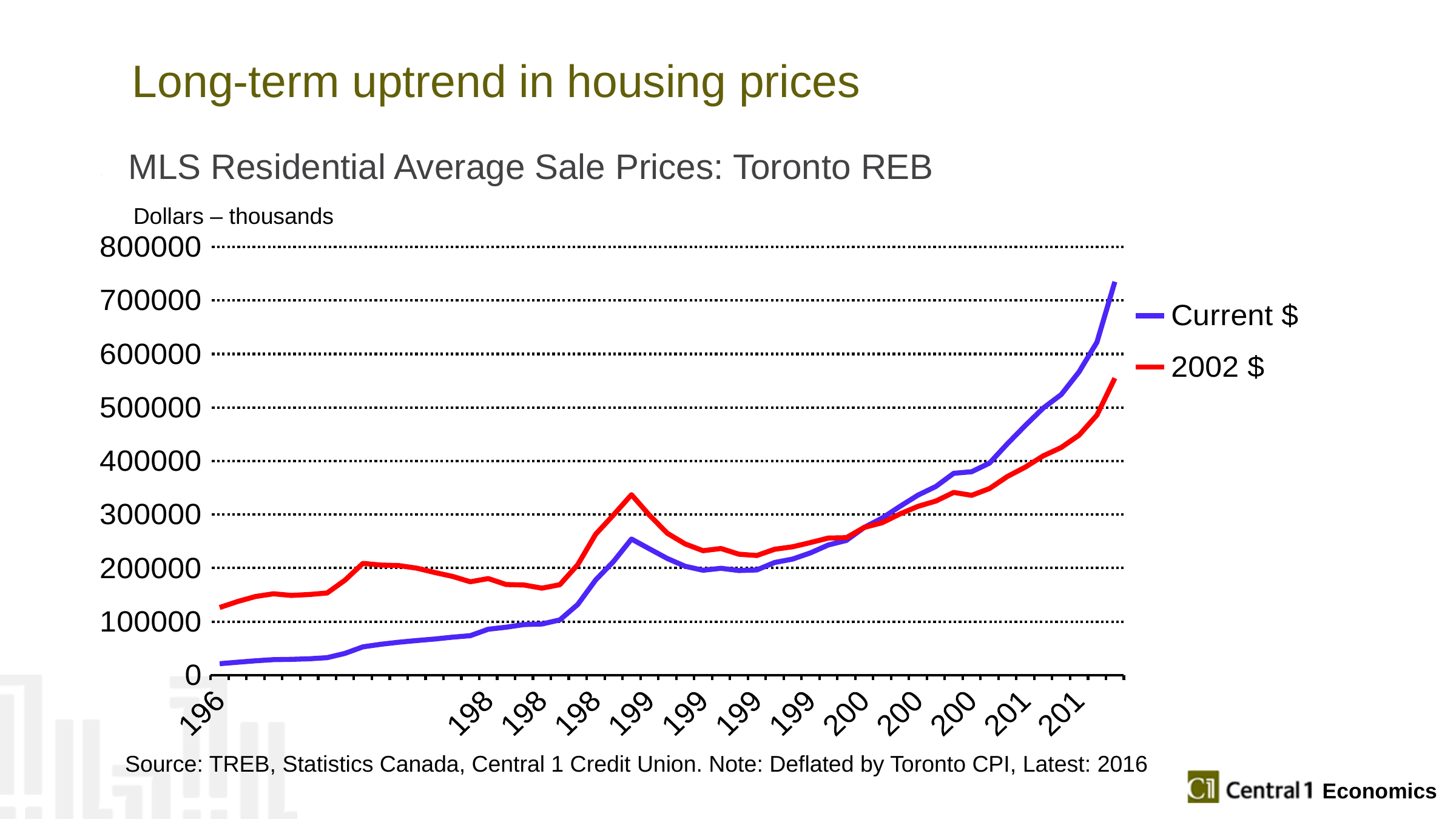
What kind of chart is shown on the slide? line chart How many series does the legend list? 2 Is the value of the Current $ series at the leftmost point greater or less than 100000? less Is the value of the 2002 $ series at the rightmost point greater or less than 500000? greater What is the title of the chart? MLS Residential Average Sale Prices: Toronto REB Is the value of the 2002 $ series at the rightmost point greater or less than 600000? less At the rightmost point, which series has the higher value, Current $ or 2002 $? Current $ Overall, does the Current $ series rise or fall from left to right along the x axis? rise At the leftmost point, which series has the higher value, Current $ or 2002 $? 2002 $ What are the two series named in the legend? Current $ and 2002 $